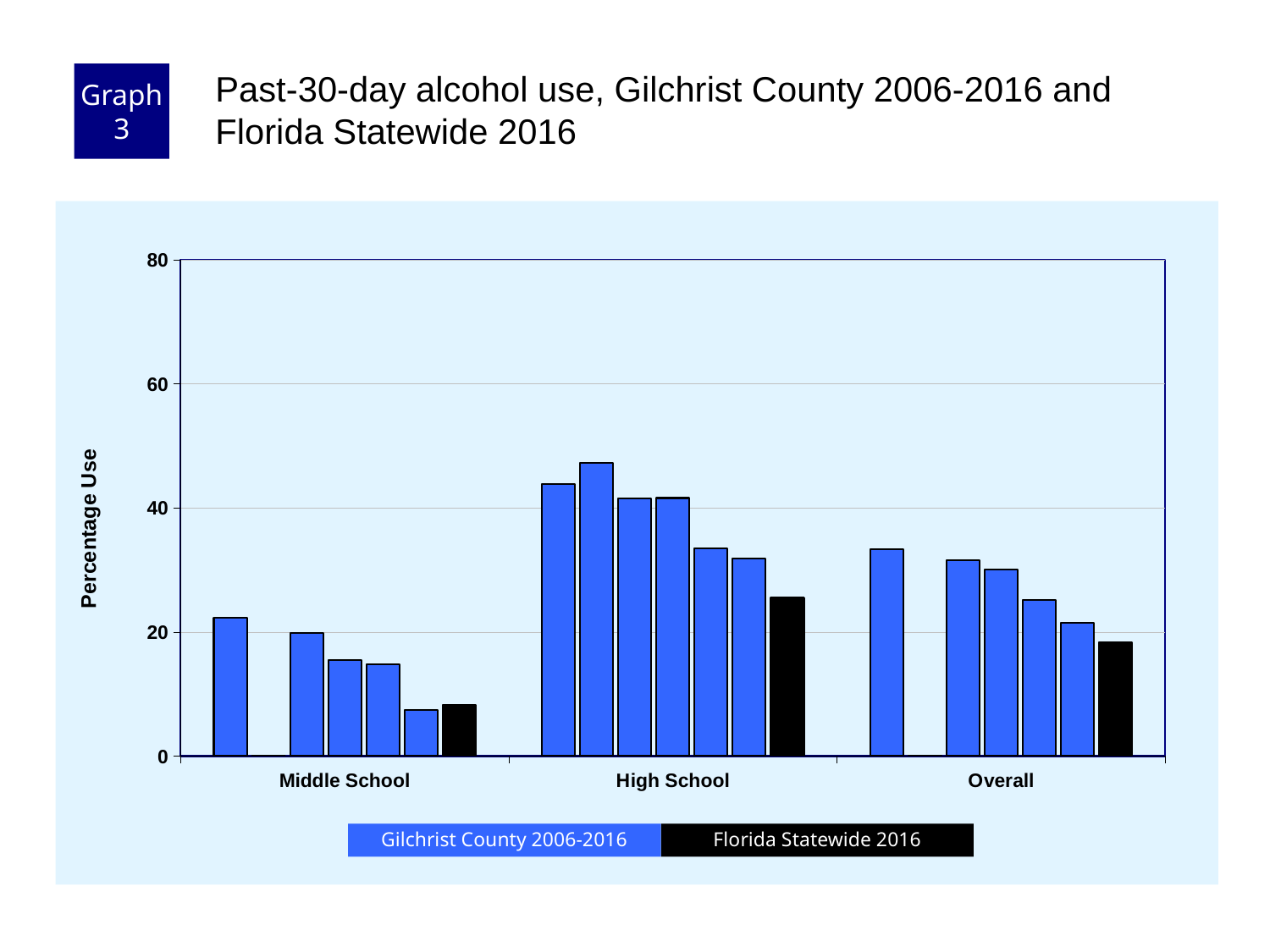
Is the Florida Statewide 2016 value for High School greater or less than 20? greater Is the tallest Gilchrist County bar in the High School group greater or less than 40? greater What is the label on the y axis? Percentage Use What kind of chart is shown on the slide? bar chart Which is larger, the Florida Statewide 2016 value for High School or for Middle School? High School Which category has the highest bars overall? High School Do the Gilchrist County 2006-2016 bars in the Middle School group rise or fall from left to right? fall Is the Florida Statewide 2016 value for Middle School greater or less than 20? less How many series does the legend list? 2 Which category has the lowest bars overall? Middle School How many school-level categories are shown on the x axis? 3